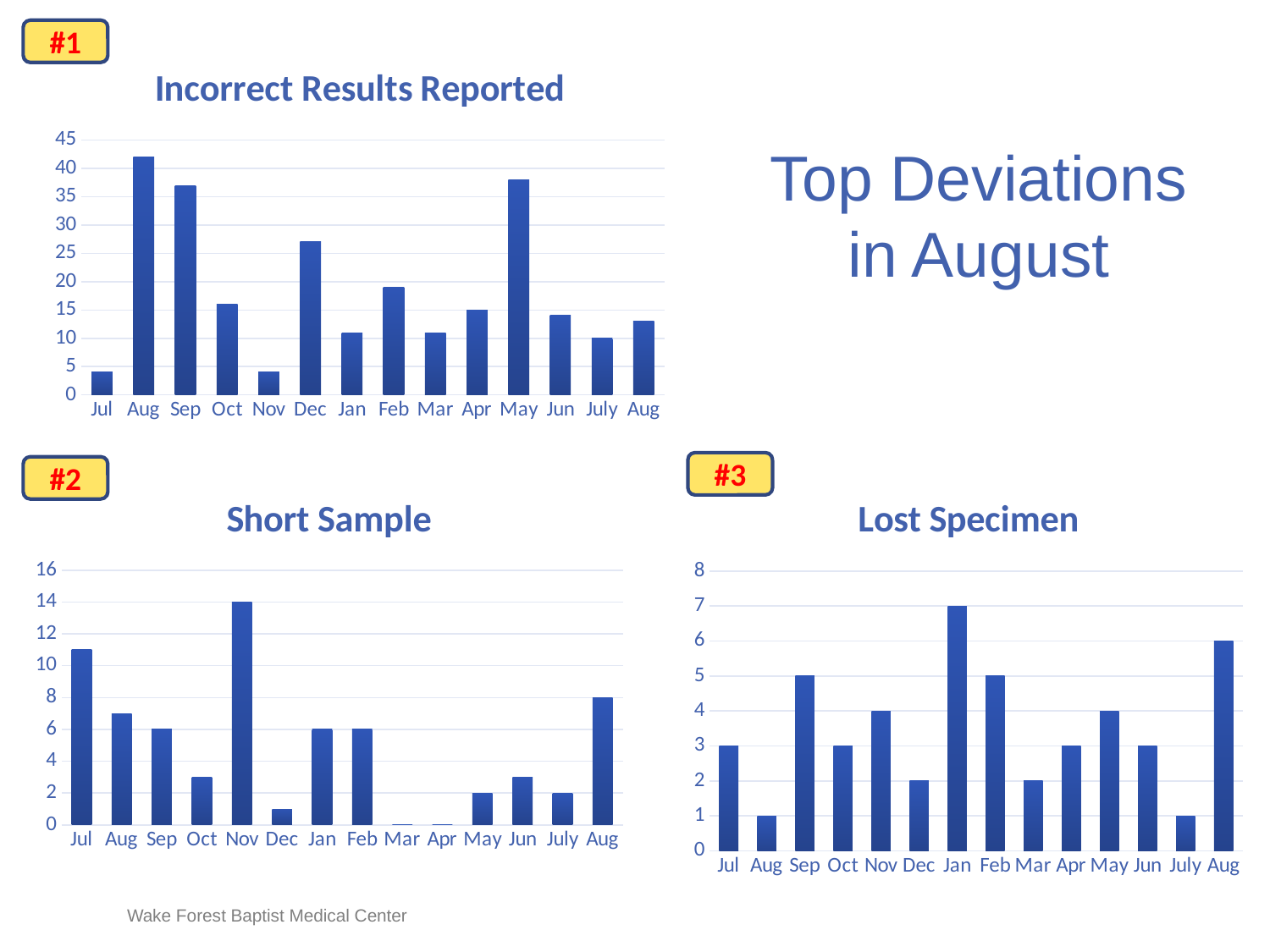
In the "Incorrect Results Reported" chart, which month has the highest value? Aug In the "Short Sample" chart, what is the value for Nov? 14 In the "Incorrect Results Reported" chart, is the value for Dec greater or less than 25? greater In the "Incorrect Results Reported" chart, is the value for Feb greater or less than 20? less In the "Lost Specimen" chart, what is the value for Jan? 7 What kind of chart is the "Incorrect Results Reported" chart? bar chart In the "Short Sample" chart, which month has the highest value? Nov In the "Lost Specimen" chart, which is larger, the value for Nov or the value for Dec? Nov In the "Short Sample" chart, what is the value for the final Aug? 8 In the "Lost Specimen" chart, what is the difference between the values for Jan and Sep? 2 How many months are shown on the x axis of the "Short Sample" chart? 14 What is the title of the chart labelled #3? Lost Specimen